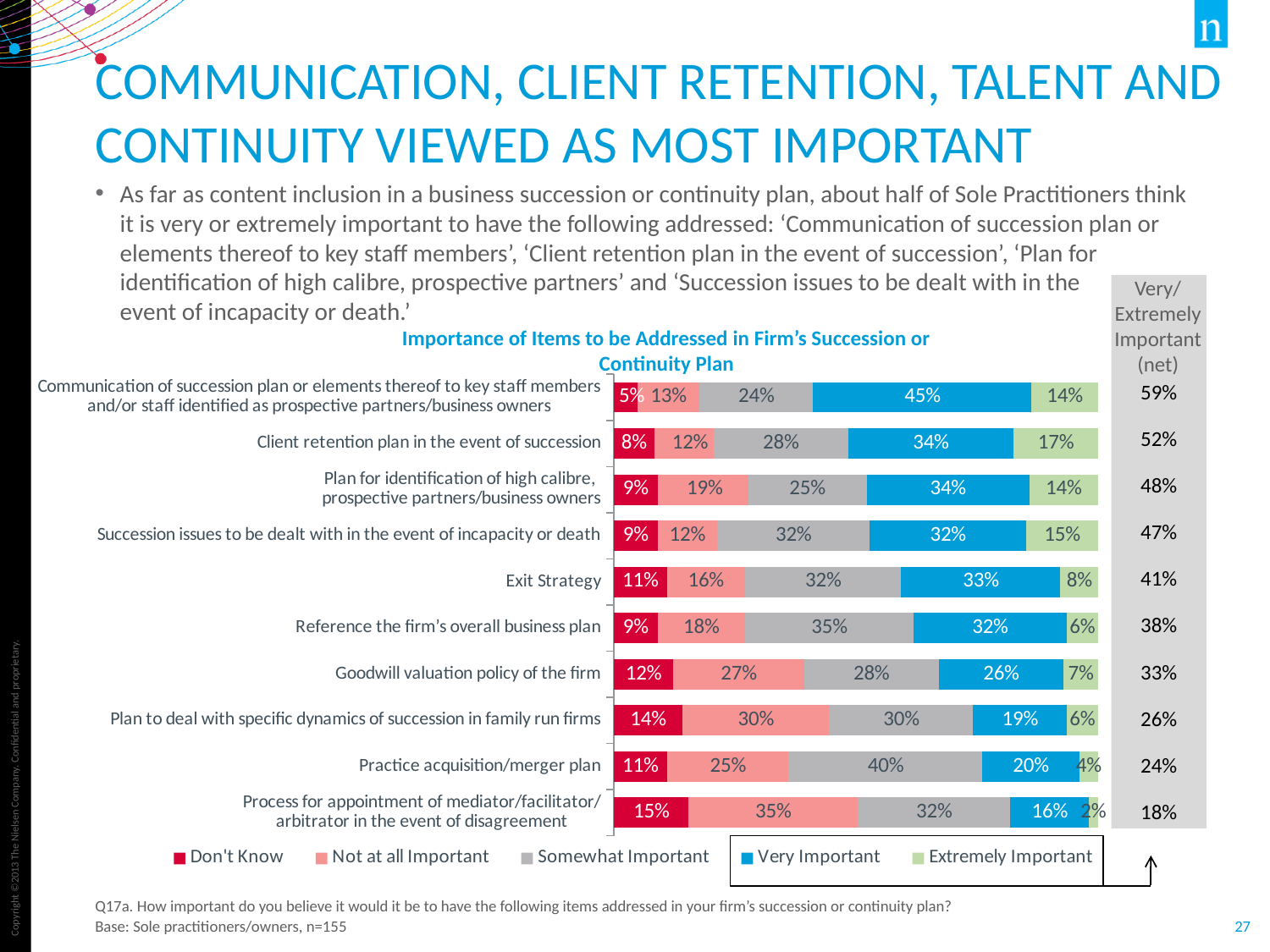
What kind of chart is shown on the slide? Stacked bar chart What percentage of respondents rated 'Client retention plan in the event of succession' as Very Important? 34% Which item has the highest Very Important value? Communication of succession plan or elements thereof to key staff members and/or staff identified as prospective partners/business owners How many items are listed in the chart? 10 What is the Very/Extremely Important (net) value for 'Goodwill valuation policy of the firm'? 33% Which has the larger Not at all Important value: 'Goodwill valuation policy of the firm' or 'Plan for identification of high calibre, prospective partners/business owners'? Goodwill valuation policy of the firm Which item has the lowest Extremely Important value? Process for appointment of mediator/facilitator/arbitrator in the event of disagreement What is the Don't Know value for 'Process for appointment of mediator/facilitator/arbitrator in the event of disagreement'? 15% How much higher is the Somewhat Important value for 'Practice acquisition/merger plan' than for 'Goodwill valuation policy of the firm'? 12 percentage points What is the Extremely Important value for 'Exit Strategy'? 8% How many series does the legend list? 5 What is the combined Don't Know and Not at all Important value for 'Exit Strategy'? 27%